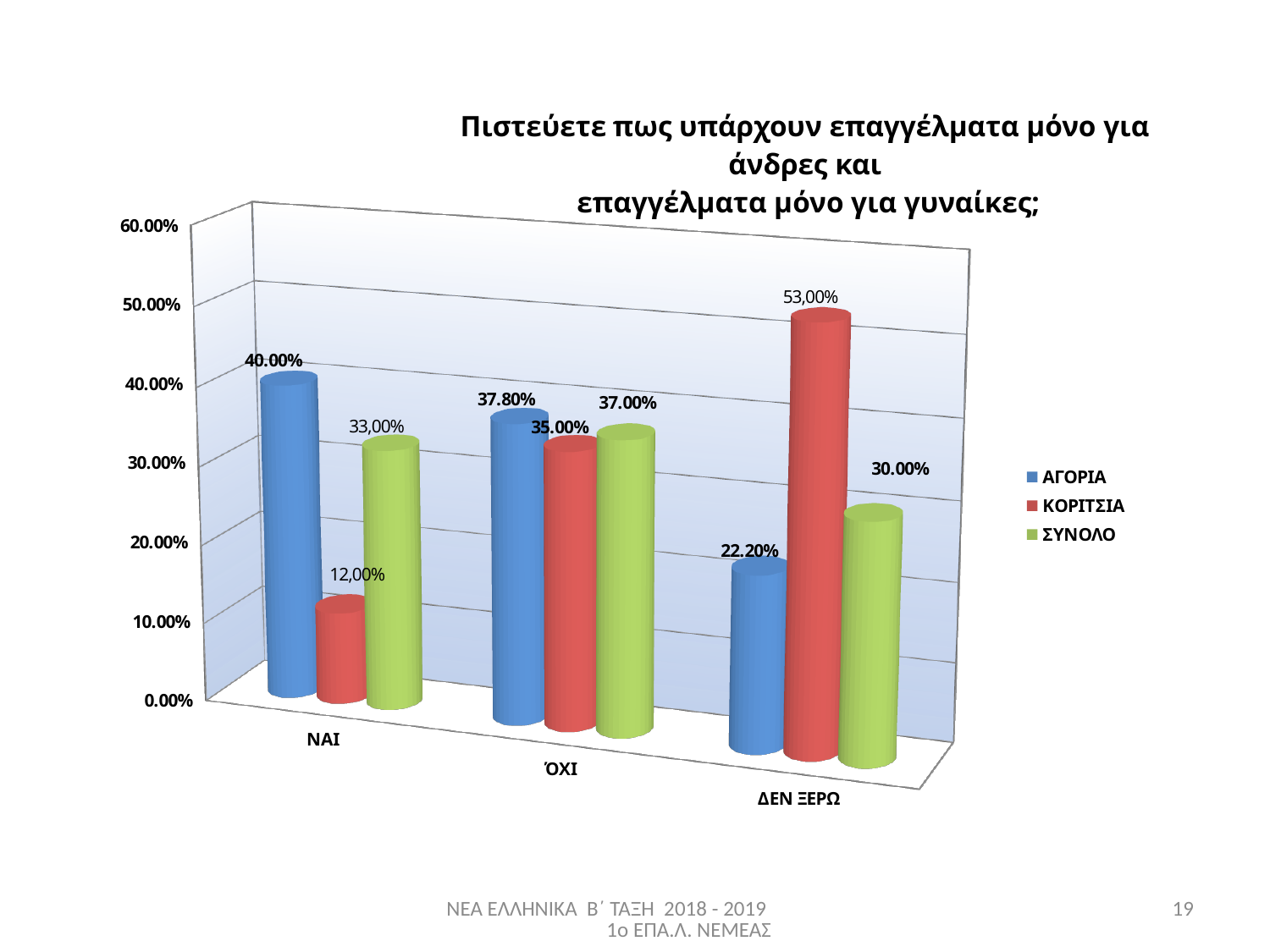
Which category has the highest value for ΚΟΡΙΤΣΙΑ? ΔΕΝ ΞΕΡΩ How many series does the legend list? 3 Which category has the lowest value for ΑΓΟΡΙΑ? ΔΕΝ ΞΕΡΩ Which colour represents the ΣΥΝΟΛΟ series? Green What is the value for ΑΓΟΡΙΑ in the ΝΑΙ category? 40.00% What is the difference between the ΑΓΟΡΙΑ and ΚΟΡΙΤΣΙΑ values in the ΝΑΙ category? 28.00% What is the value for ΚΟΡΙΤΣΙΑ in the ΝΑΙ category? 12,00% How many categories are shown on the x axis? 3 What is the value for ΚΟΡΙΤΣΙΑ in the ΔΕΝ ΞΕΡΩ category? 53,00% Which is larger in the ΔΕΝ ΞΕΡΩ category: the ΑΓΟΡΙΑ value or the ΣΥΝΟΛΟ value? ΣΥΝΟΛΟ What is the value for ΣΥΝΟΛΟ in the ΌΧΙ category? 37.00% What kind of chart is shown on the slide? Bar chart